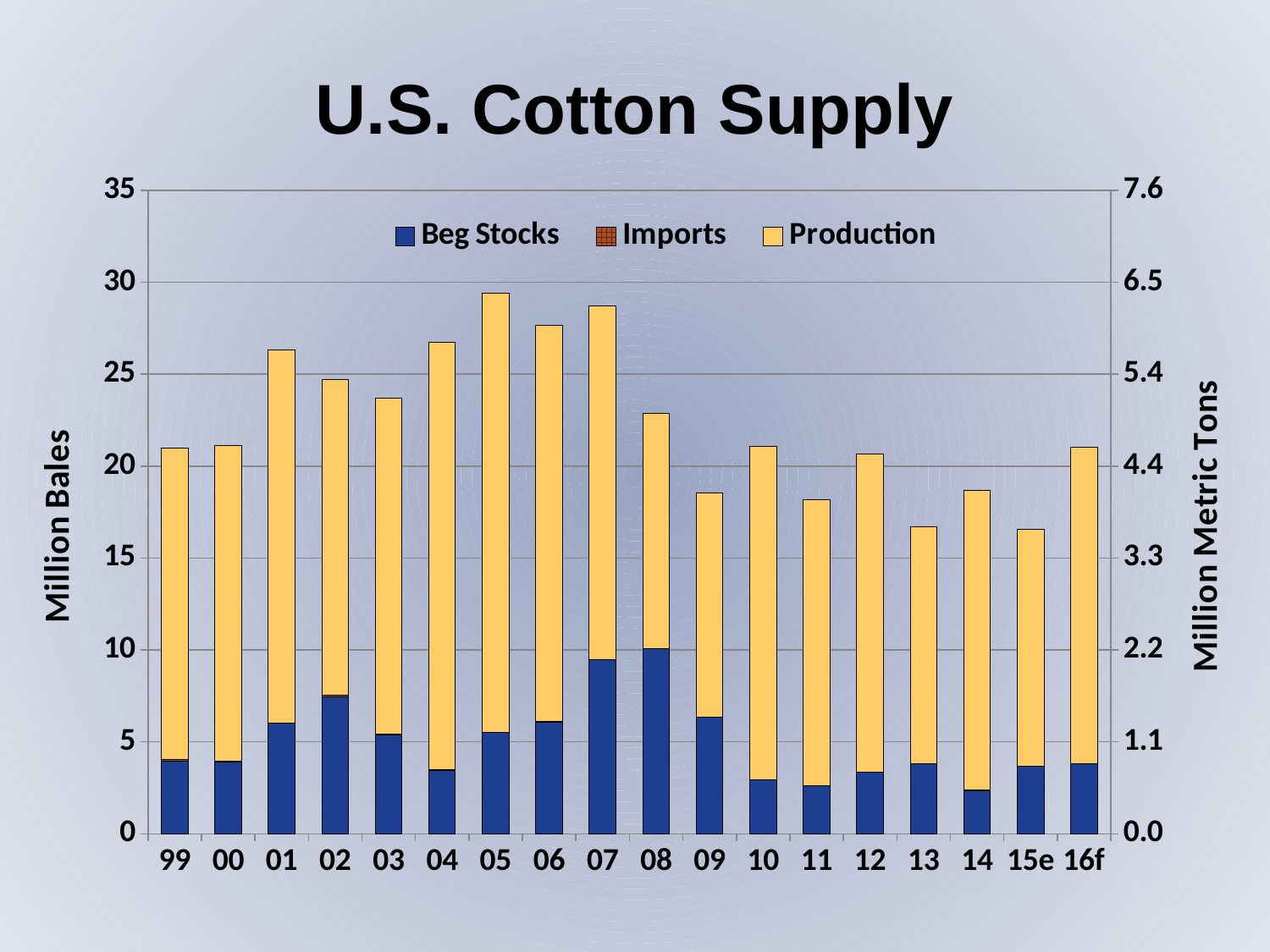
Which year has the largest Beg Stocks segment? 08 Is the Beg Stocks value for 08 greater or less than 5 million bales? greater Which year has the larger total supply bar, 05 or 08? 05 How many series does the legend list? 3 Is the total supply for 05 greater or less than 25 million bales? greater Do the total supply bars rise or fall from 03 to 05? rise How many years are shown along the x axis? 18 Is the total supply for 13 greater or less than 20 million bales? less Which year has the highest total supply bar? 05 What is the title of the left vertical axis? Million Bales What kind of chart is shown on the slide? stacked bar chart